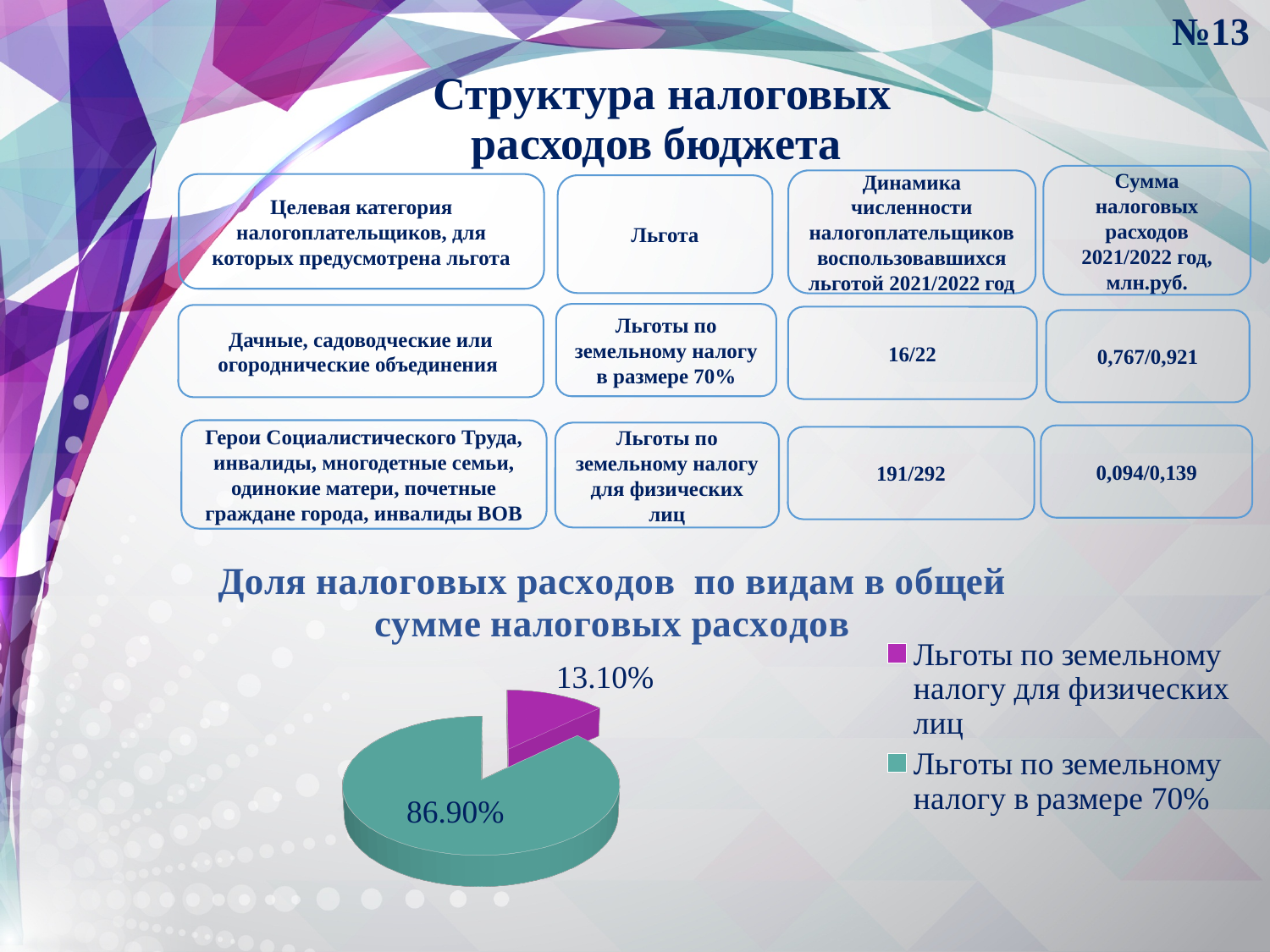
How many entries does the legend of the pie chart list? 2 What colour is the slice for "Льготы по земельному налогу для физических лиц"? purple Which slice of the pie is the largest? Льготы по земельному налогу в размере 70% What share of the pie does "Льготы по земельному налогу для физических лиц" have? 13.10% What is the difference in percentage points between the two slices of the pie? 73.80% Which slice of the pie is the smallest? Льготы по земельному налогу для физических лиц How many slices does the pie chart have? 2 Which is larger: the share for "Льготы по земельному налогу в размере 70%" or the share for "Льготы по земельному налогу для физических лиц"? Льготы по земельному налогу в размере 70% What kind of chart is shown on the slide? pie chart What share of the pie does "Льготы по земельному налогу в размере 70%" have? 86.90% What is the title of the pie chart? Доля налоговых расходов по видам в общей сумме налоговых расходов